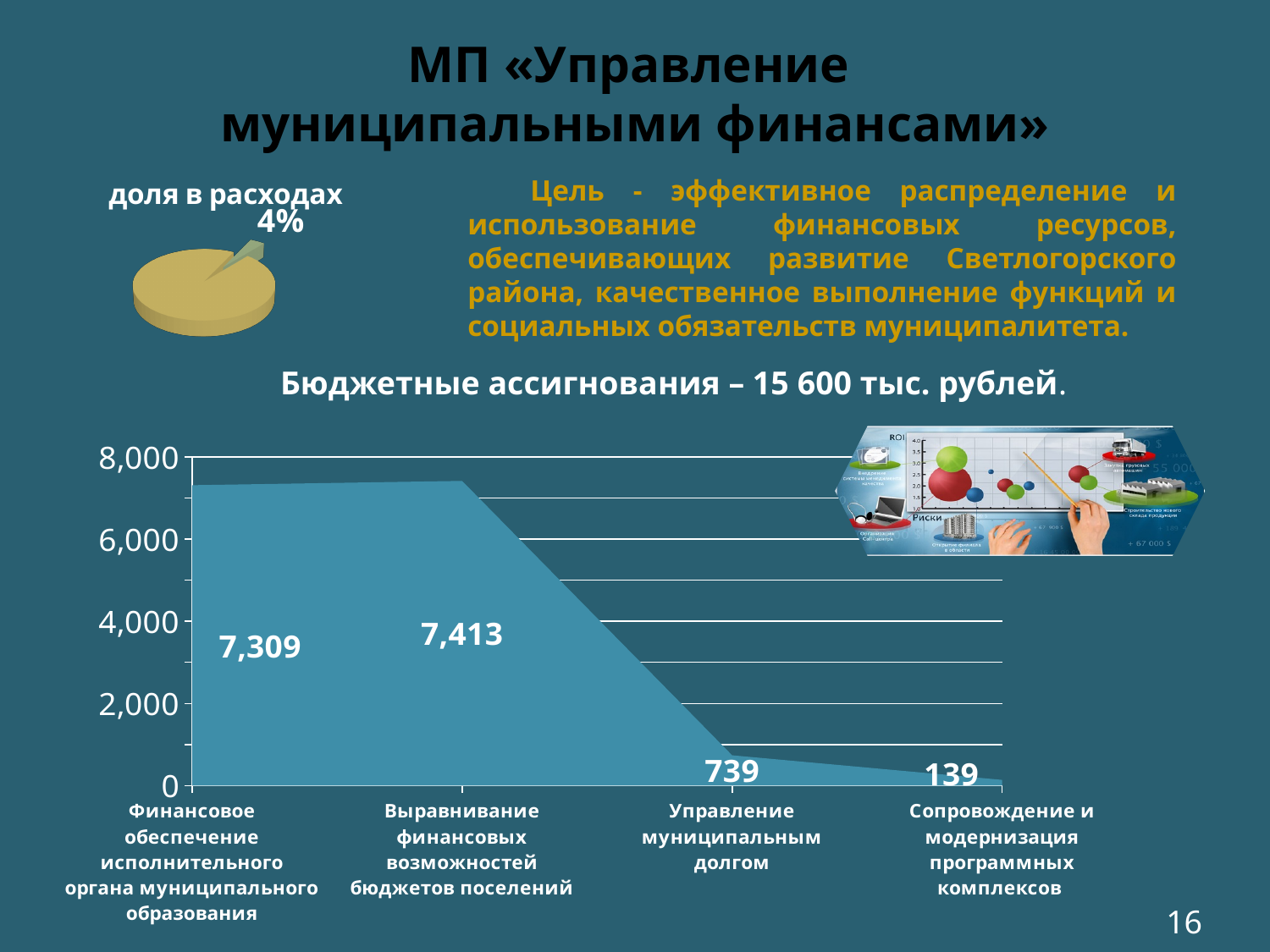
In the pie chart labelled «доля в расходах», what share does the highlighted slice represent? 4% In the area chart at the bottom of the slide, what is the value for «Финансовое обеспечение исполнительного органа муниципального образования»? 7,309 In the area chart at the bottom of the slide, what is the difference between the values for «Управление муниципальным долгом» and «Сопровождение и модернизация программных комплексов»? 600 In the area chart at the bottom of the slide, which category has the highest value? Выравнивание финансовых возможностей бюджетов поселений In the area chart at the bottom of the slide, what is the difference between the values for «Выравнивание финансовых возможностей бюджетов поселений» and «Финансовое обеспечение исполнительного органа муниципального образования»? 104 In the area chart at the bottom of the slide, which category has the lowest value? Сопровождение и модернизация программных комплексов In the area chart at the bottom of the slide, which is larger: the value for «Финансовое обеспечение исполнительного органа муниципального образования» or for «Выравнивание финансовых возможностей бюджетов поселений»? Выравнивание финансовых возможностей бюджетов поселений How many categories are shown on the x axis of the area chart at the bottom of the slide? 4 In the area chart at the bottom of the slide, is the value for «Управление муниципальным долгом» greater or less than 2,000? less What kind of chart is the chart at the bottom of the slide? area chart In the area chart at the bottom of the slide, what is the value for «Управление муниципальным долгом»? 739 In the area chart at the bottom of the slide, what is the value for «Сопровождение и модернизация программных комплексов»? 139